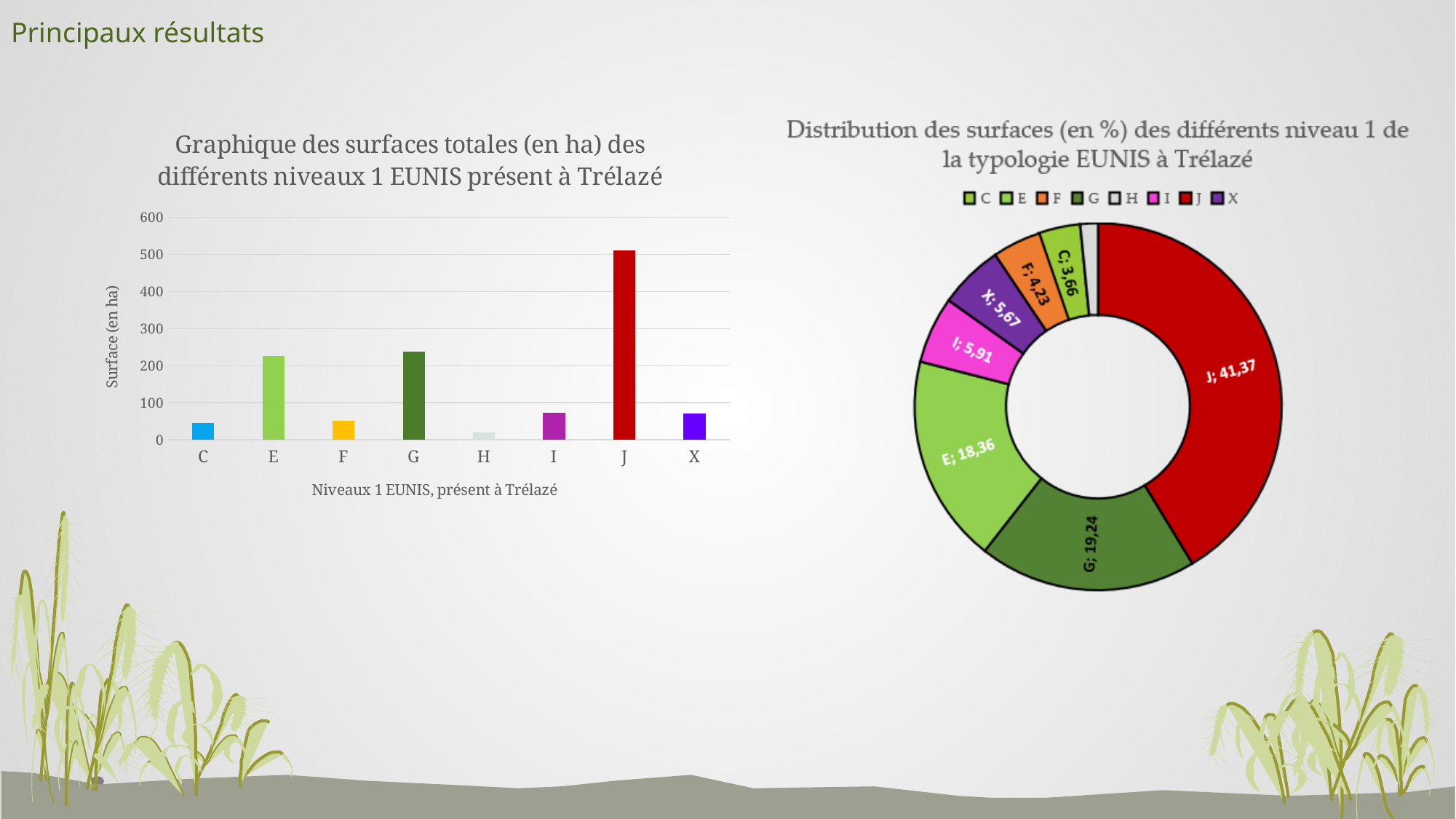
What kind of chart is the left chart, 'Graphique des surfaces totales (en ha)'? bar chart In the left bar chart, which is larger, the value for J or the value for G? J In the left bar chart, how many categories are shown on the x axis? 8 In the right chart, 'Distribution des surfaces (en %)', what is the difference between the shares of G and E? 0,88 In the right chart, 'Distribution des surfaces (en %)', how many entries does the legend list? 8 In the right chart, 'Distribution des surfaces (en %)', what is the share for X? 5,67 In the left bar chart, which category has the highest surface? J In the left bar chart, which category has the lowest surface? H In the right chart, 'Distribution des surfaces (en %)', what is the share for G? 19,24 In the left bar chart, is the value for J greater or less than 400? greater In the right chart, 'Distribution des surfaces (en %)', what is the share for J? 41,37 In the left bar chart, is the value for E greater or less than 200? greater